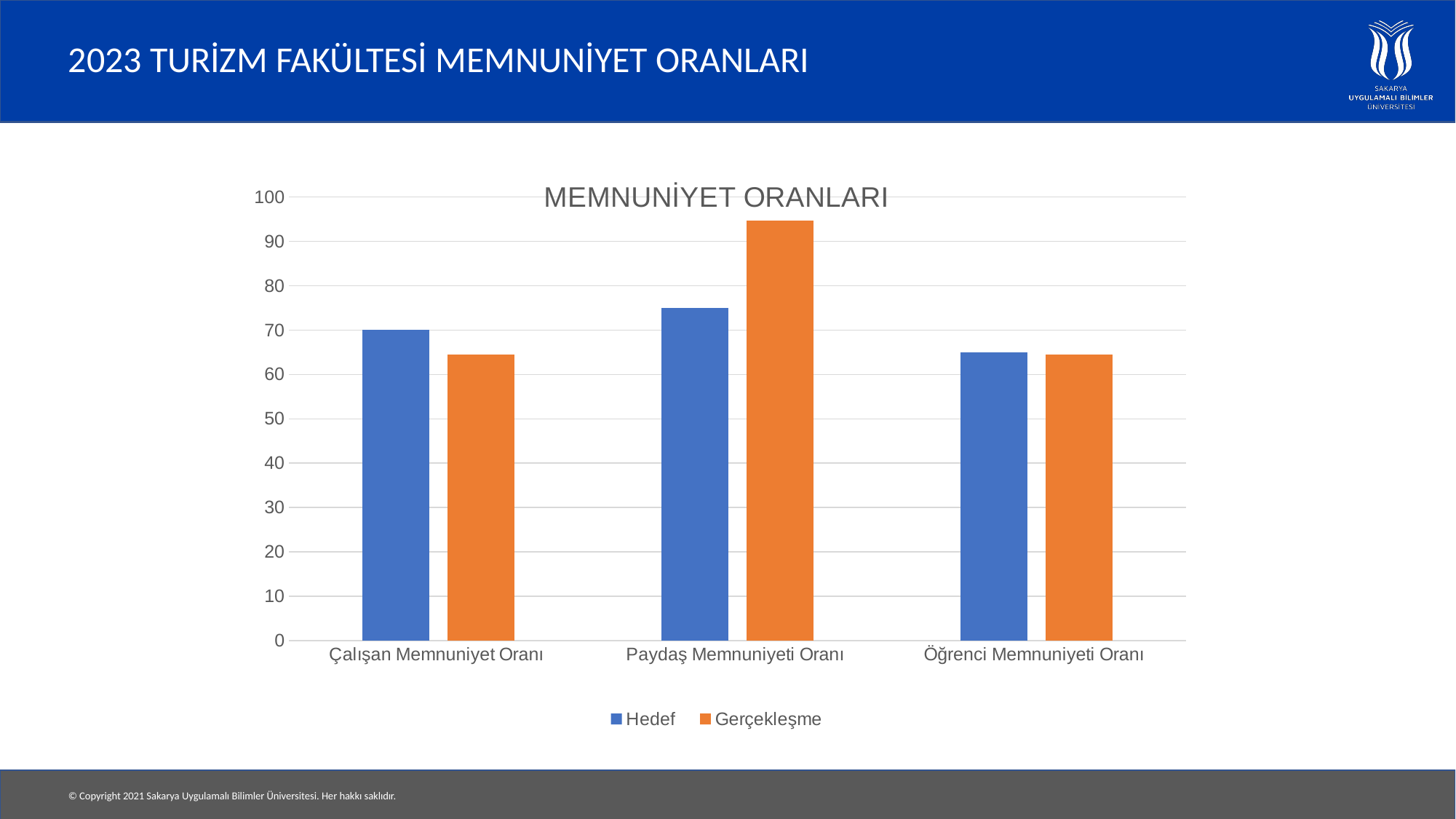
For Paydaş Memnuniyeti Oranı, which is larger: Hedef or Gerçekleşme? Gerçekleşme Which category has the highest Gerçekleşme value? Paydaş Memnuniyeti Oranı What kind of chart is shown on the slide? Bar chart What is the Hedef value for Çalışan Memnuniyet Oranı? 70 How many categories are shown on the x axis? 3 Which series is shown in orange? Gerçekleşme Is the Gerçekleşme value for Çalışan Memnuniyet Oranı greater or less than 70? less Is the Gerçekleşme value for Paydaş Memnuniyeti Oranı greater or less than 90? greater What is the title of the chart? MEMNUNİYET ORANLARI Which category has the highest Hedef value? Paydaş Memnuniyeti Oranı How many series does the legend list? 2 For Çalışan Memnuniyet Oranı, which is larger: Hedef or Gerçekleşme? Hedef